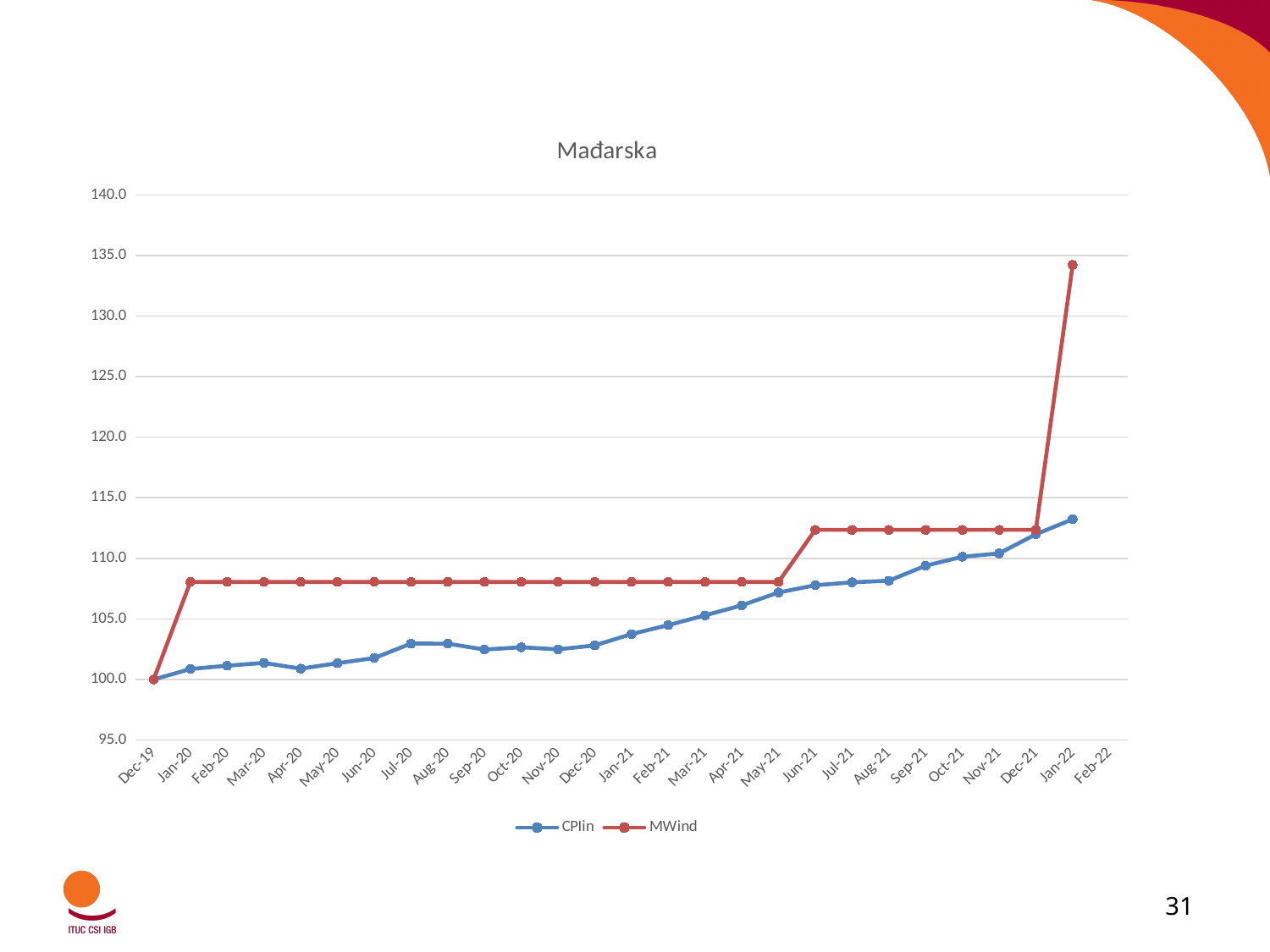
Is the value of CPlin at Jun-20 greater or less than 105? less What is the value of the MWind series at Dec-19? 100.0 How many series does the legend list? 2 What kind of chart is shown on the slide? line chart At which month is the CPlin series at its lowest value? Dec-19 Is the value of CPlin at Jan-22 greater or less than 115? less What is the title of the chart? Mađarska Is the value of MWind at Jan-22 greater or less than 130? greater At which month does the MWind series reach its highest value? Jan-22 At Jan-22, which series has the larger value, CPlin or MWind? MWind What are the names of the two series in the legend? CPlin and MWind